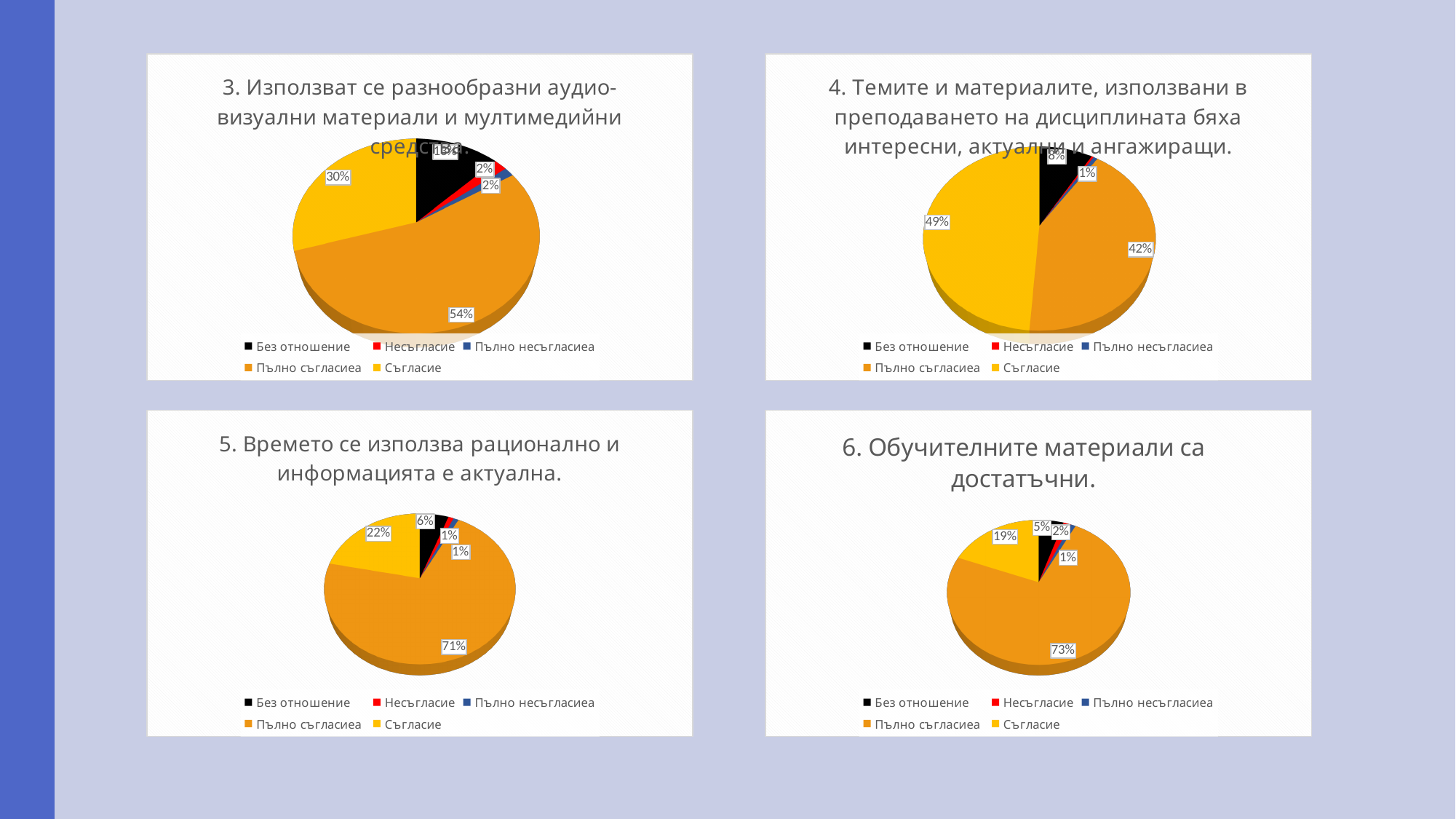
In the top-right chart (question 4), what percentage is shown for Съгласие? 49% In the bottom-left chart (question 5), what is the difference between the Пълно съгласиеа slice and the Съгласие slice? 49% How many pie charts are shown on the slide? 4 How many entries does the legend list in the top-left chart (question 3)? 5 In the top-right chart (question 4), which category has the largest slice? Съгласие In the chart titled "6. Обучителните материали са достатъчни.", what percentage is shown for Съгласие? 19% What kind of chart is used for question 5 (bottom-left)? Pie chart In the top-right chart (question 4), what is the difference between the Съгласие slice and the Пълно съгласиеа slice? 7% In the bottom-right chart (question 6), which is larger: the Без отношение slice or the Несъгласие slice? Без отношение In the bottom-right chart (question 6), which category has the largest slice? Пълно съгласиеа In the top-left chart (question 3), what percentage is shown for Пълно съгласиеа? 54% In the chart titled "5. Времето се използва рационално и информацията е актуална.", what percentage is shown for Пълно съгласиеа? 71%